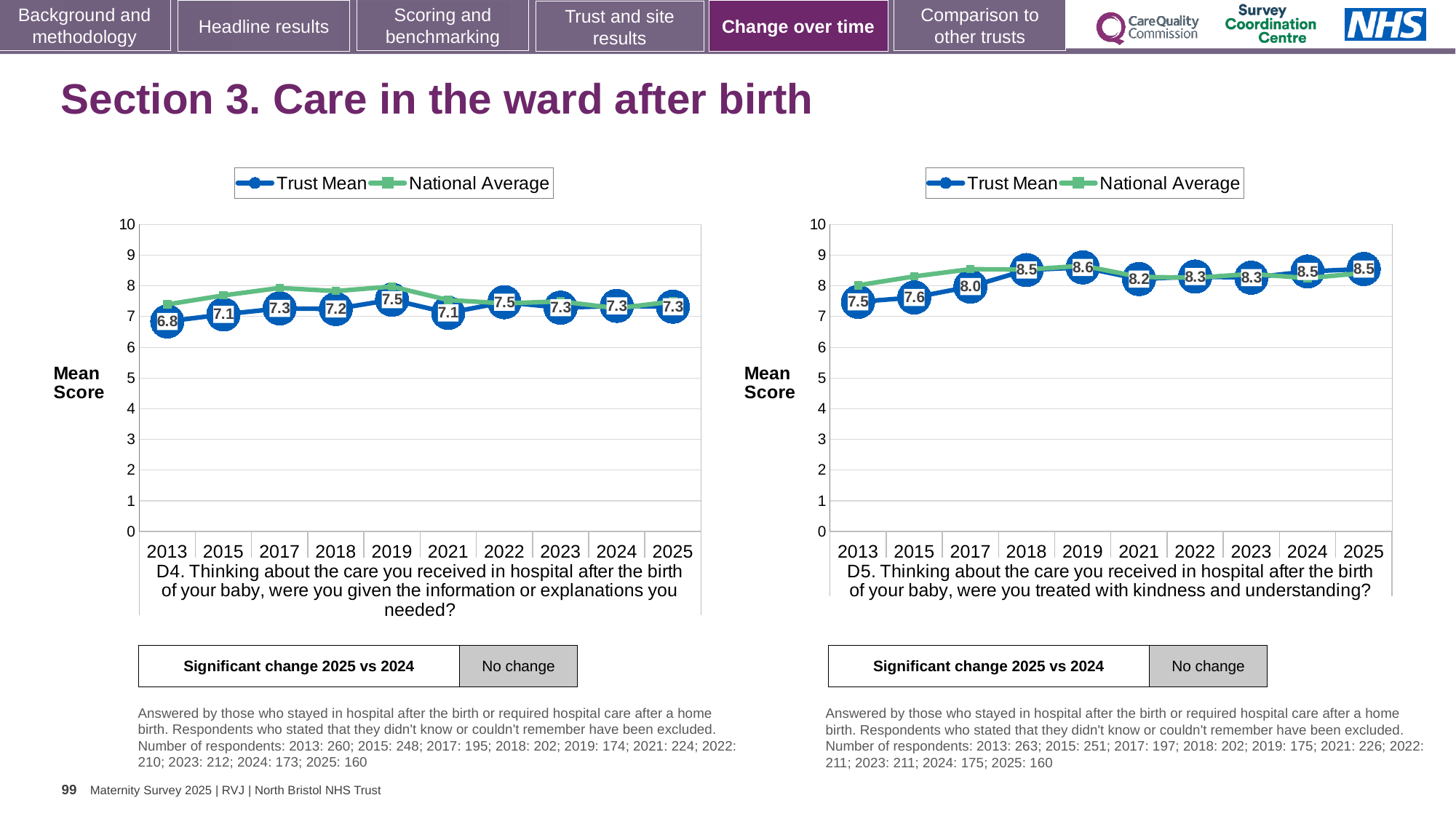
On the left chart (D4), what is the Trust Mean score for 2025? 7.3 On the left chart (D4), which year has the lowest Trust Mean score? 2013 On the left chart (D4), is the Trust Mean score for 2019 or 2021 larger? 2019 On the left chart (D4), is the National Average for 2013 greater or less than 7? greater On the right chart (D5), what is the Trust Mean score for 2017? 8.0 On the right chart (D5), which year has the lowest Trust Mean score? 2013 On the right chart (D5), which year has the highest Trust Mean score? 2019 What type of chart is the right chart (D5)? Line chart On the left chart (D4), what is the Trust Mean score for 2013? 6.8 How many years are plotted on the right chart (D5)? 10 On the right chart (D5), what is the difference between the Trust Mean scores for 2019 and 2013? 1.1 How many series does the legend of the left chart (D4) list? 2